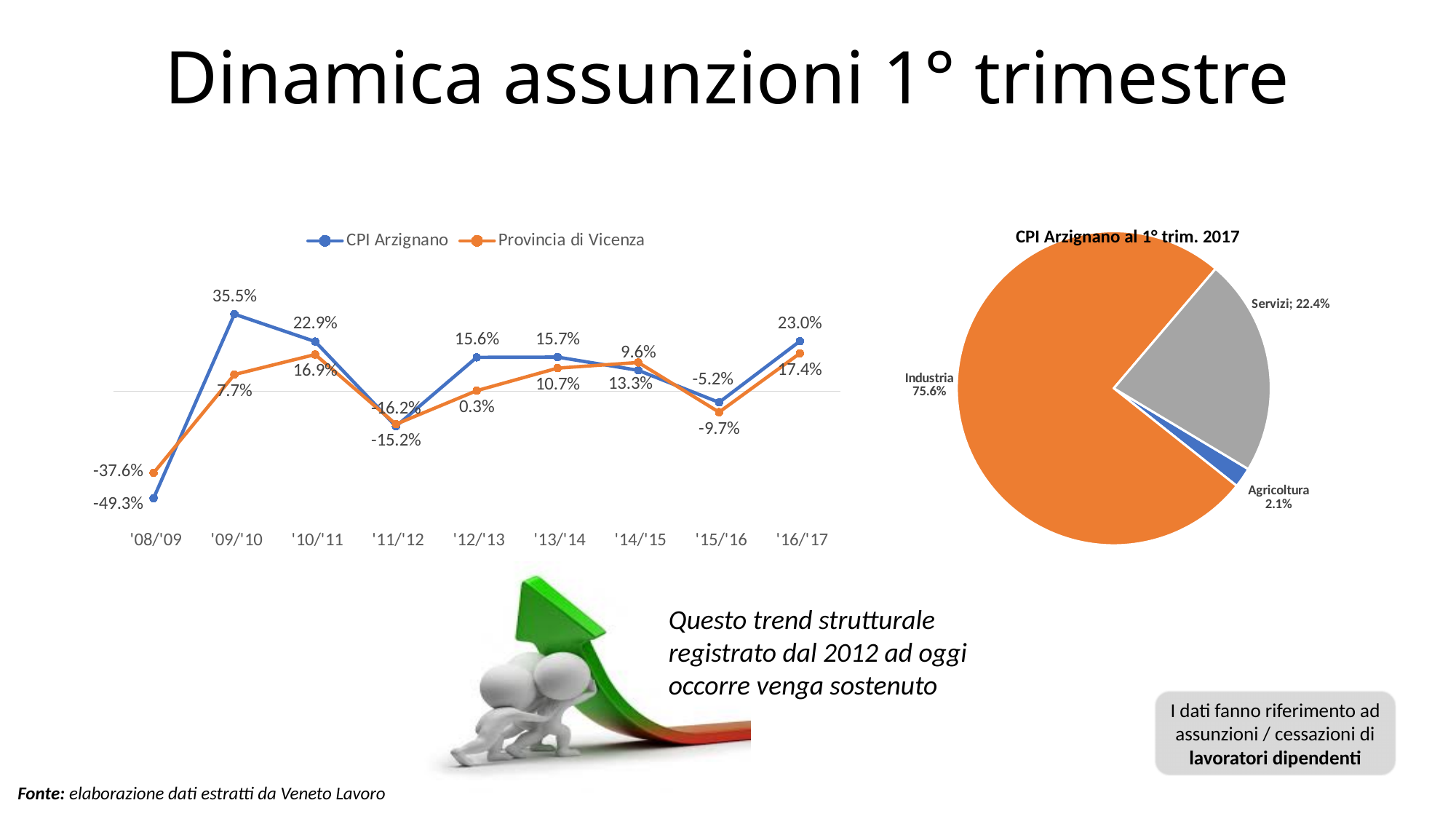
In the line chart on the left, which period has the highest value for Provincia di Vicenza? '16/'17 How many periods are shown on the x axis of the line chart on the left? 9 What kind of chart is the one on the right of the slide? Pie chart In the line chart on the left, what is the difference between CPI Arzignano and Provincia di Vicenza in '09/'10? 27.8% In the line chart on the left, which series has the larger value in '15/'16, CPI Arzignano or Provincia di Vicenza? CPI Arzignano In the line chart on the left, which period has the lowest value for CPI Arzignano? '08/'09 In the pie chart titled 'CPI Arzignano al 1° trim. 2017', which sector has the smallest slice? Agricoltura In the line chart on the left, what is the value for CPI Arzignano in '16/'17? 23.0% In the line chart on the left, what is the value for Provincia di Vicenza in '12/'13? 0.3% In the line chart on the left, what is the value for CPI Arzignano in '09/'10? 35.5% How many series does the legend of the line chart on the left list? 2 In the pie chart titled 'CPI Arzignano al 1° trim. 2017', what share does Industria have? 75.6%